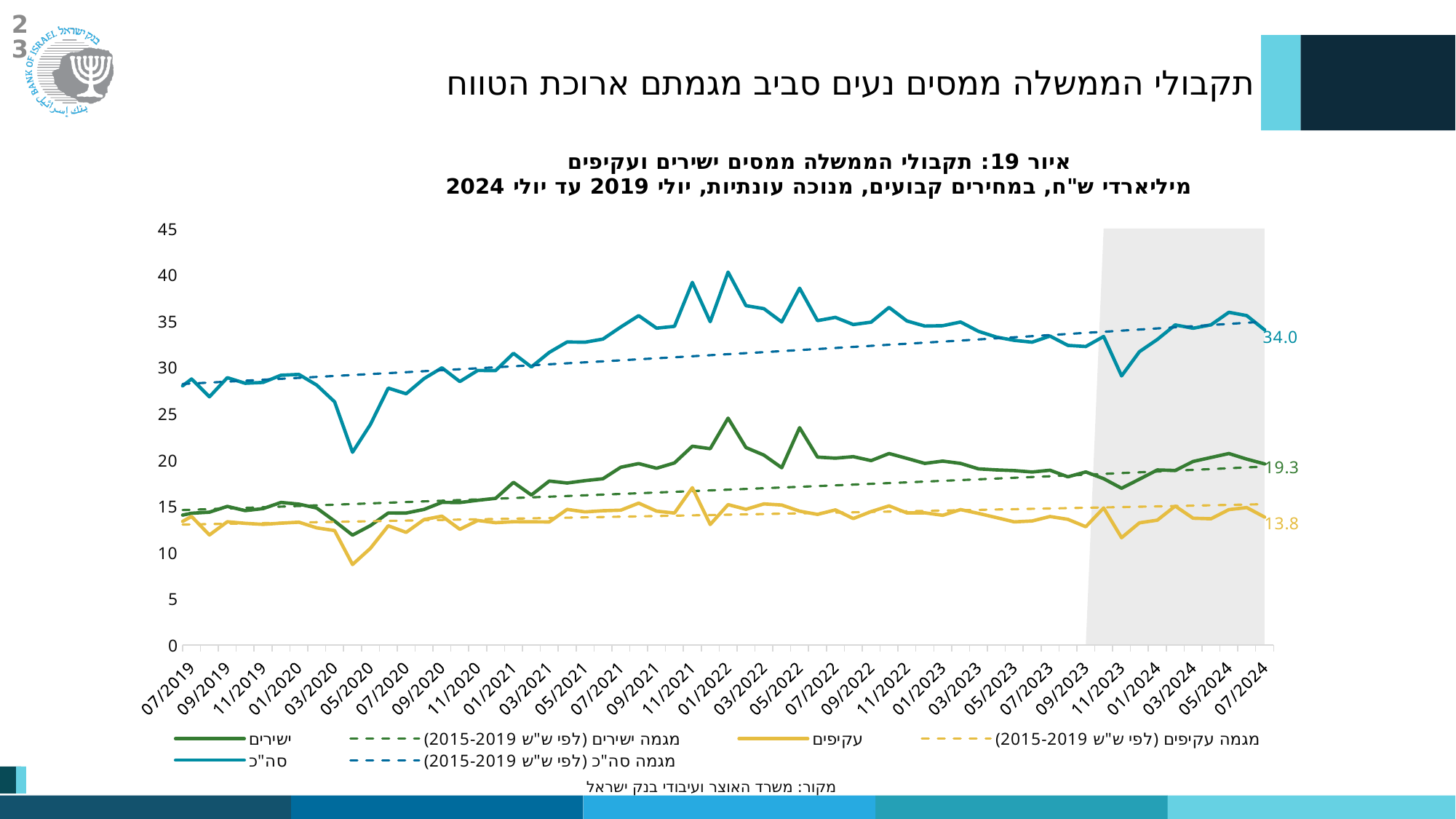
Which series has the lowest value at 07/2024? עקיפים What kind of chart is shown on the slide? Line chart How many series does the legend list? 6 Which series has the highest value at 07/2024? סה"כ Is the value of the סה"כ series at 05/2020 greater or less than 25? less Does the סה"כ series rise or fall overall from 07/2019 to 07/2024? rise What is the value of the סה"כ series at 07/2024? 34.0 What is the figure number given in the chart title? איור 19 What is the value of the עקיפים series at 07/2024? 13.8